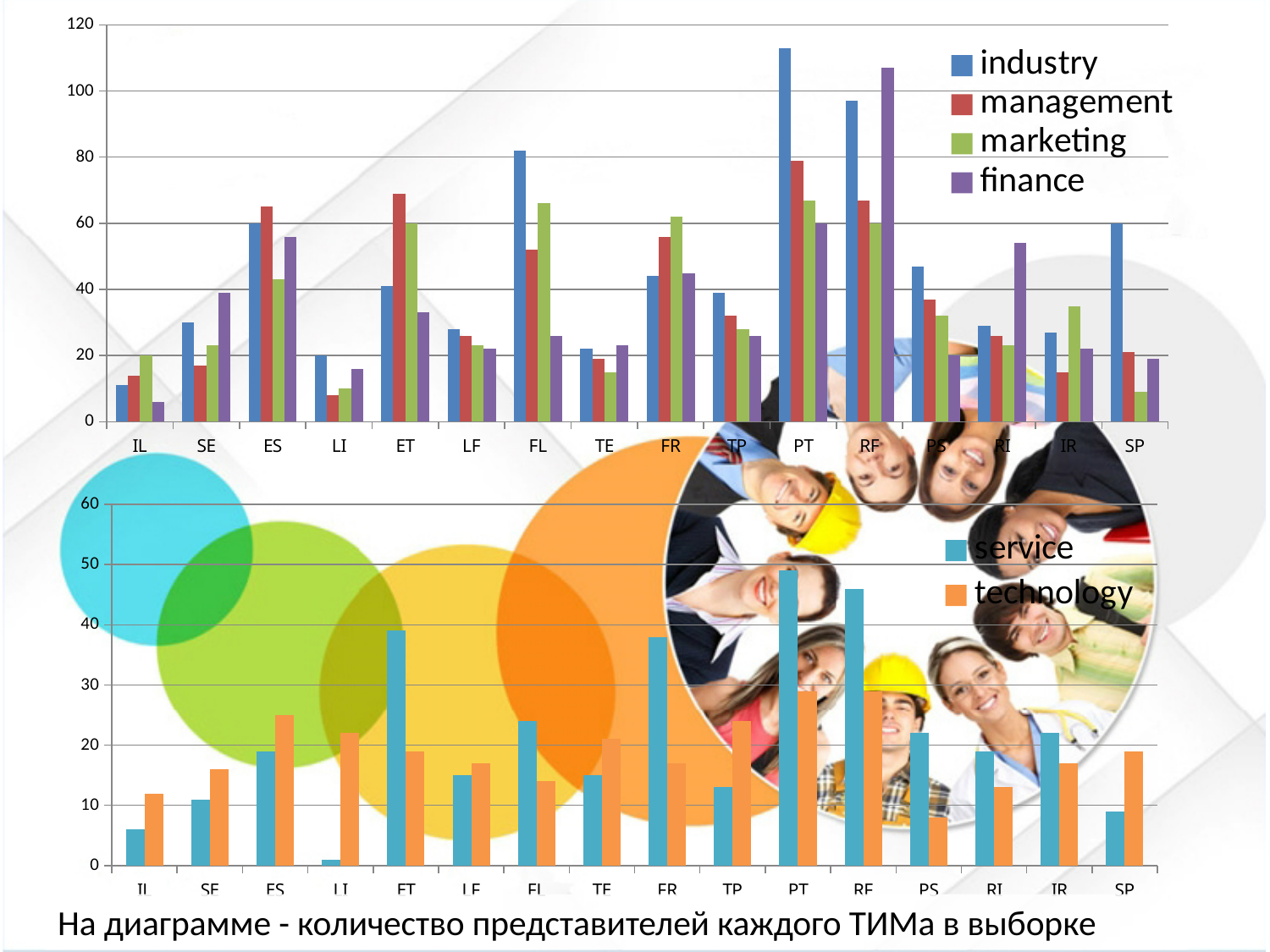
In the top chart, for category ET, which is larger: industry or management? management How many categories are shown on the x axis of the bottom chart? 16 How many series does the legend of the bottom chart list? 2 How many series does the legend of the top chart list? 4 In the top chart, which category has the lowest industry value? IL In the bottom chart, is the service value for ET greater or less than 30? greater In the top chart, which category has the highest industry value? PT In the bottom chart, which category has the lowest service value? LI In the bottom chart, for category ET, which is larger: service or technology? service In the top chart, is the industry value for PT greater or less than 100? greater What kind of chart is the top chart on the slide? bar chart In the top chart, which category has the highest finance value? RF